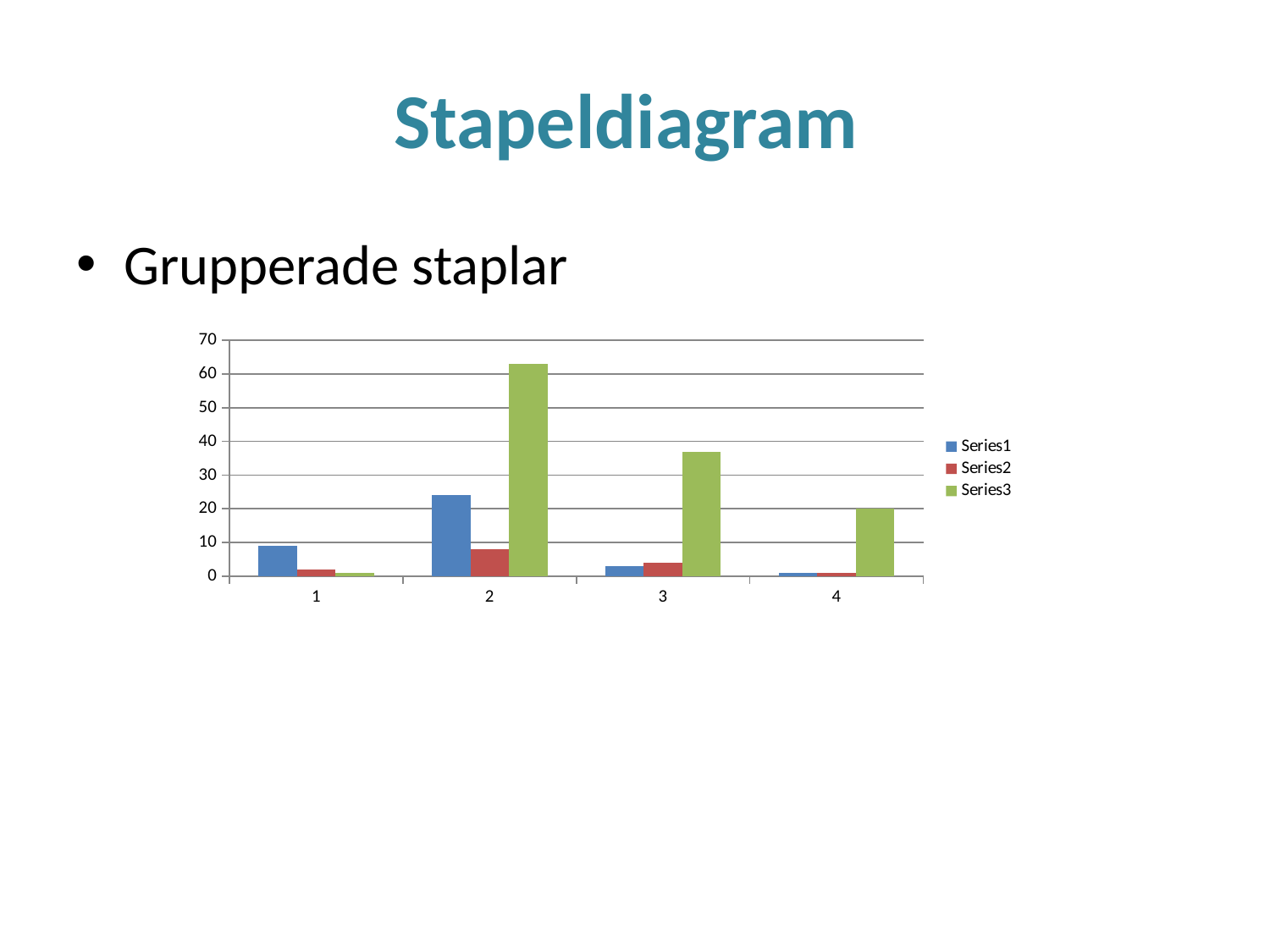
Is the value for Series3 in category 3 greater or less than 40? less What kind of chart is shown on the slide? bar chart Which colour represents Series3 in the chart? green Which category has the highest value for Series3? 2 Which category has the highest value for Series1? 2 How many categories are shown on the x axis of the chart? 4 In category 3, which is larger: Series2 or Series3? Series3 Is the value for Series3 in category 2 greater or less than 60? greater In category 1, which is larger: Series1 or Series2? Series1 How many series does the chart's legend list? 3 Is the value for Series1 in category 2 greater or less than 20? greater